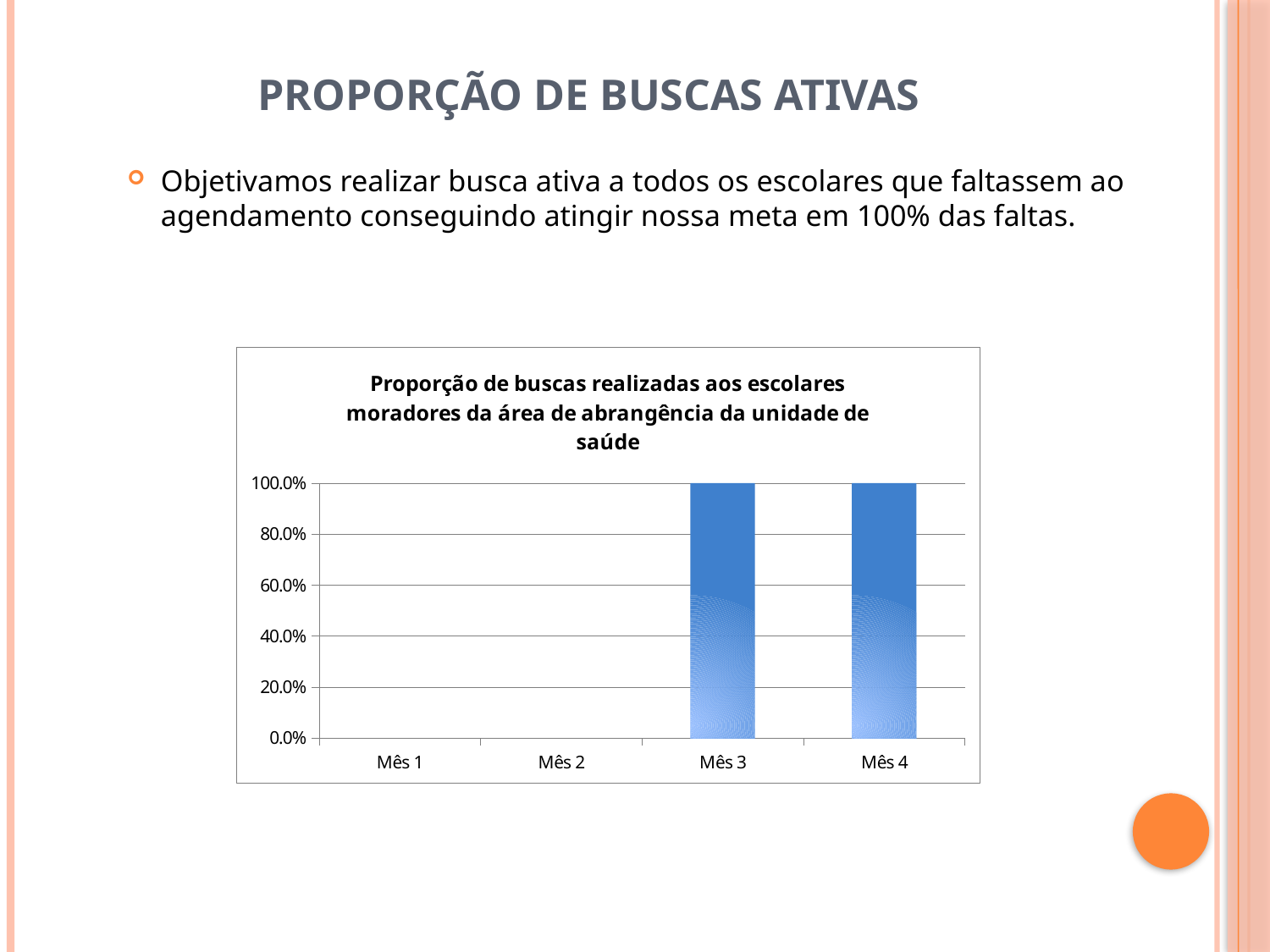
Do the values in the chart rise or fall from Mês 2 to Mês 3? rise What is the value for Mês 1 in the chart? 0.0% How many categories are shown on the x axis of the chart? 4 Which is larger in the chart, the value for Mês 2 or the value for Mês 3? Mês 3 What is the difference between the value for Mês 4 and the value for Mês 1? 100.0% What kind of chart is shown on the slide? bar chart What is the value for Mês 3 in the chart? 100.0% What is the value for Mês 4 in the chart? 100.0% Is the value for Mês 3 greater or less than 60.0%? greater What is the highest value shown on the vertical axis of the chart? 100.0% What is the value for Mês 2 in the chart? 0.0% What is the title of the chart? Proporção de buscas realizadas aos escolares moradores da área de abrangência da unidade de saúde